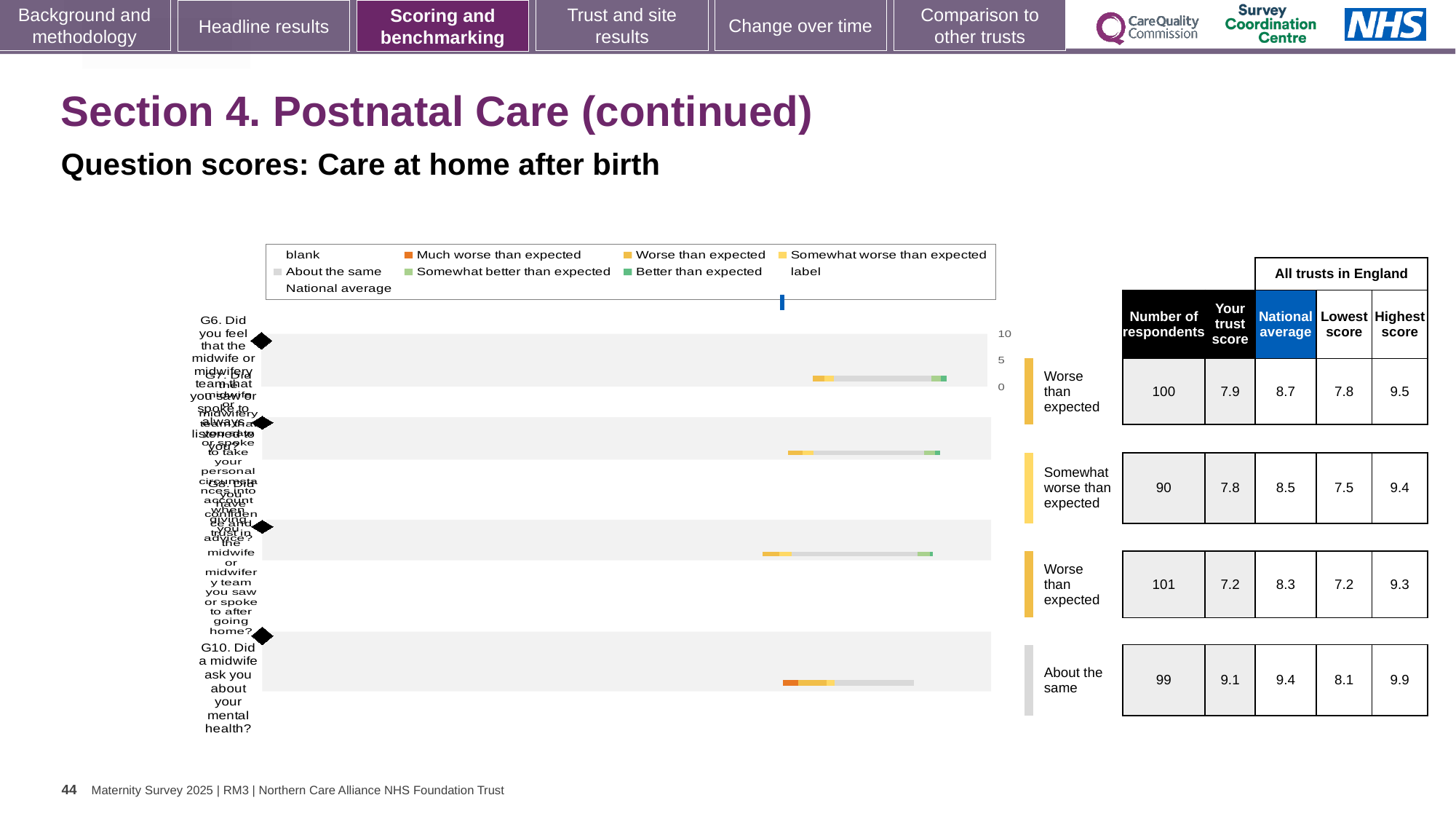
What is the subtitle above the chart? Question scores: Care at home after birth In the table beside the chart, what is the national average for the first row (G6)? 8.7 What kind of chart is shown on the slide? bar chart In the table beside the chart, how many respondents are listed for G10? 99 Which question row has the highest trust score in the table? G10 (9.1) How many question rows (bars) does the chart show? 4 For G10, which is larger: the trust score or the national average? national average (9.4) For the first row (G6), what is the difference between the highest score and the lowest score in the table? 1.7 What is the lowest trust score shown in the table? 7.2 What colour does the legend use for "Much worse than expected"? orange In the table beside the chart, what is the trust score for G10 (Did a midwife ask you about your mental health?)? 9.1 What benchmark category is shown for the G10 row? About the same